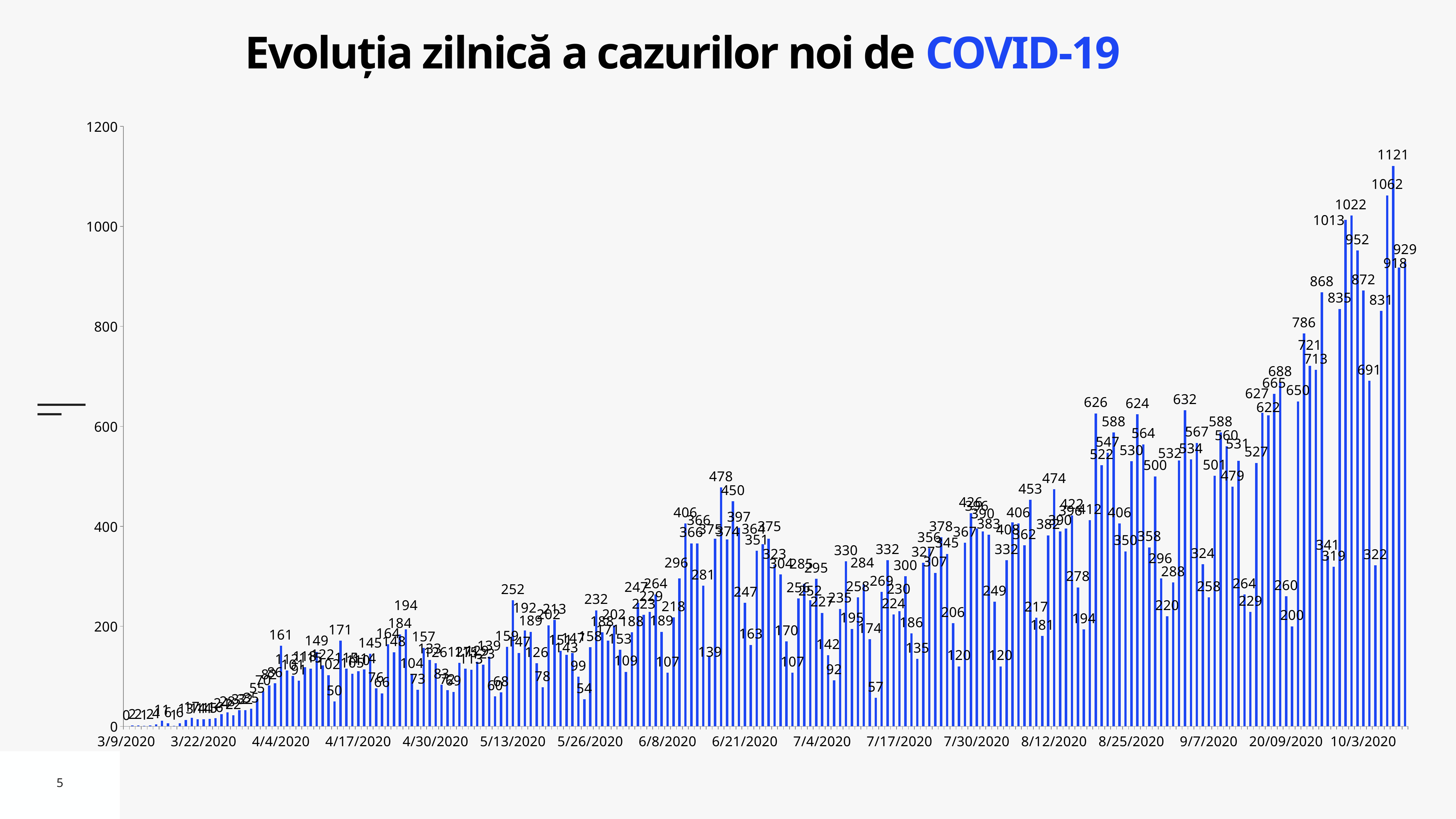
Which is larger, the bar labelled 1121 or the bar labelled 1062? 1121 What is the highest tick value shown on the y axis? 1200 What is the difference between the two highest labelled values, 1121 and 1062? 59 What is the last date label on the x axis? 10/3/2020 Overall, do the daily values rise or fall from left to right along the x axis? rise Is the highest value on the chart greater or less than 1000? greater What kind of chart is shown on the slide? bar chart What is the highest daily value shown on the chart? 1121 What is the lowest value labelled on the chart? 0 What is the first date label on the x axis? 3/9/2020 What is the title of the chart? Evoluția zilnică a cazurilor noi de COVID-19 What is the second highest daily value labelled on the chart? 1062